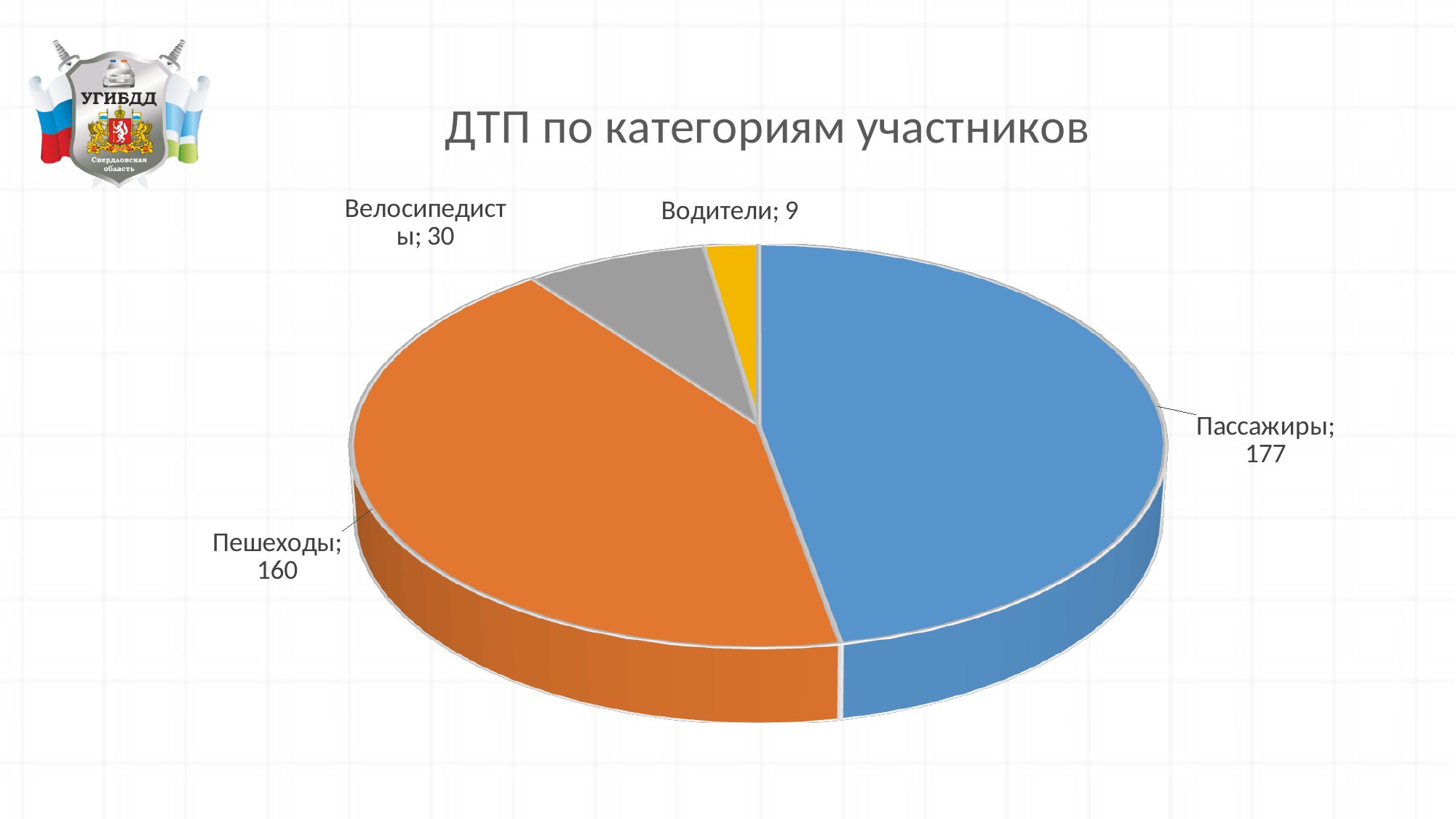
Which category has the lowest value? Водители What is the difference between the values for Пассажиры and Пешеходы? 17 Which category has the highest value? Пассажиры What is the value for Водители? 9 What is the title of the chart? ДТП по категориям участников What is the value for Пешеходы? 160 What is the difference between the values for Велосипедисты and Водители? 21 Which is larger, the value for Пешеходы or the value for Велосипедисты? Пешеходы What kind of chart is shown on the slide? Pie chart What is the value for Велосипедисты? 30 What is the value for Пассажиры? 177 How many categories are shown in the pie chart? 4